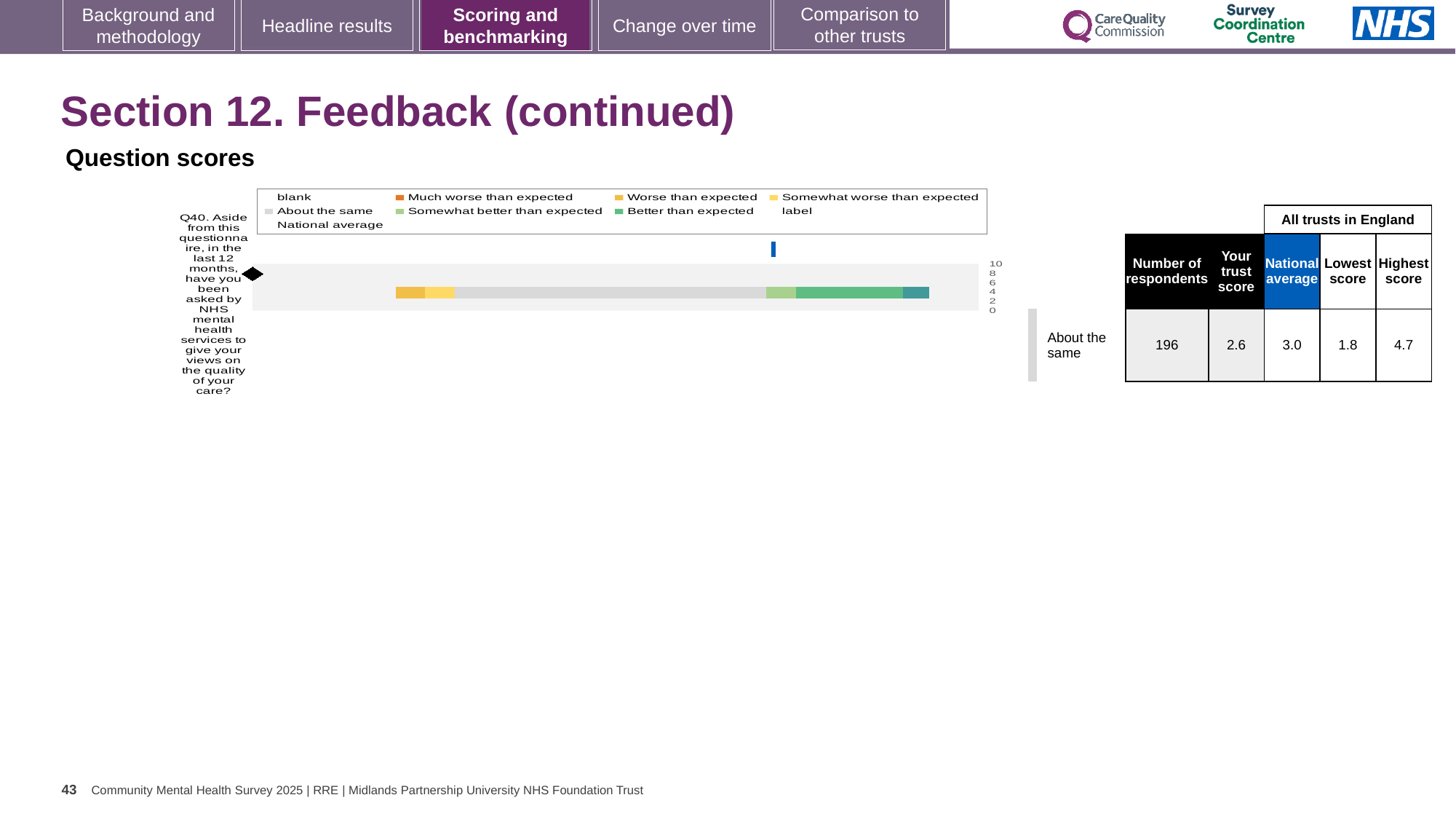
What colour is used for the 'About the same' segment in the chart? grey In the table beside the chart, how many respondents answered Q40? 196 In the table beside the chart, what is the difference between the highest score and the lowest score for Q40? 2.9 In the table beside the chart, what is the trust score for Q40? 2.6 In the table beside the chart, is the trust score for Q40 higher or lower than the national average? lower Is the 'About the same' segment of the bar wider or narrower than the 'Worse than expected' segment? wider How many questions (categories) are plotted in the chart? 1 How many entries does the chart legend list? 9 What kind of chart is shown on the slide? bar chart In the table beside the chart, what is the national average for Q40? 3.0 Which question is the chart about? Q40. Aside from this questionnaire, in the last 12 months, have you been asked by NHS mental health services to give your views on the quality of your care? Which legend category occupies the widest segment of the bar? About the same